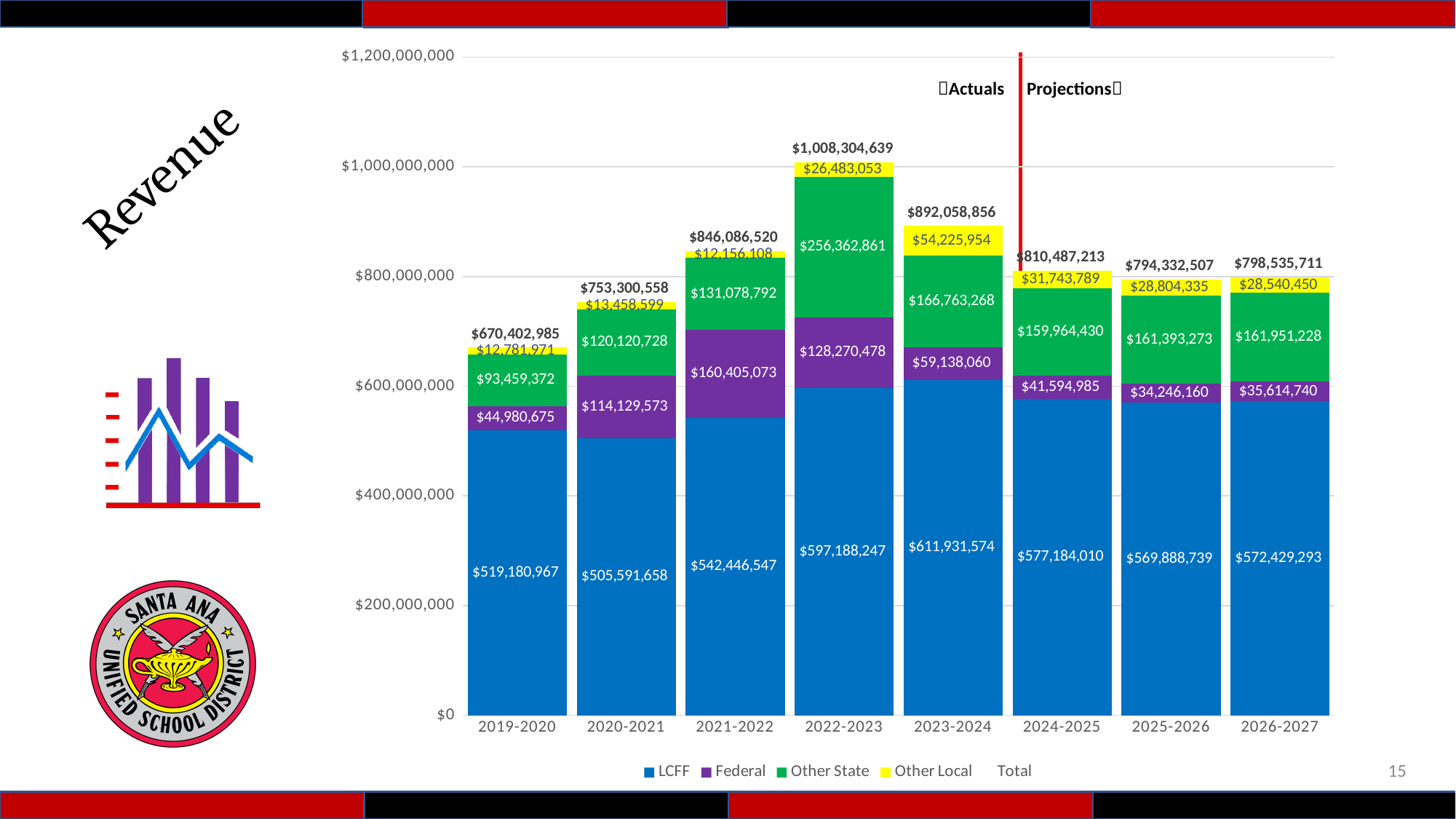
How many fiscal years are shown on the x axis? 8 Which year has the lowest total revenue? 2019-2020 What is the total revenue shown for 2023-2024? $892,058,856 Which is larger, the Other State value for 2020-2021 or the Other State value for 2021-2022? 2021-2022 What kind of chart is shown on the slide? stacked bar chart Is the total revenue for 2024-2025 greater or less than $800,000,000? greater Which year has the highest total revenue? 2022-2023 What is the difference between the total revenue for 2022-2023 and 2023-2024? $116,245,783 What is the Federal value for 2026-2027? $35,614,740 Which year has the highest Federal value? 2021-2022 What is the Other State value for 2019-2020? $93,459,372 What is the LCFF value for 2022-2023? $597,188,247